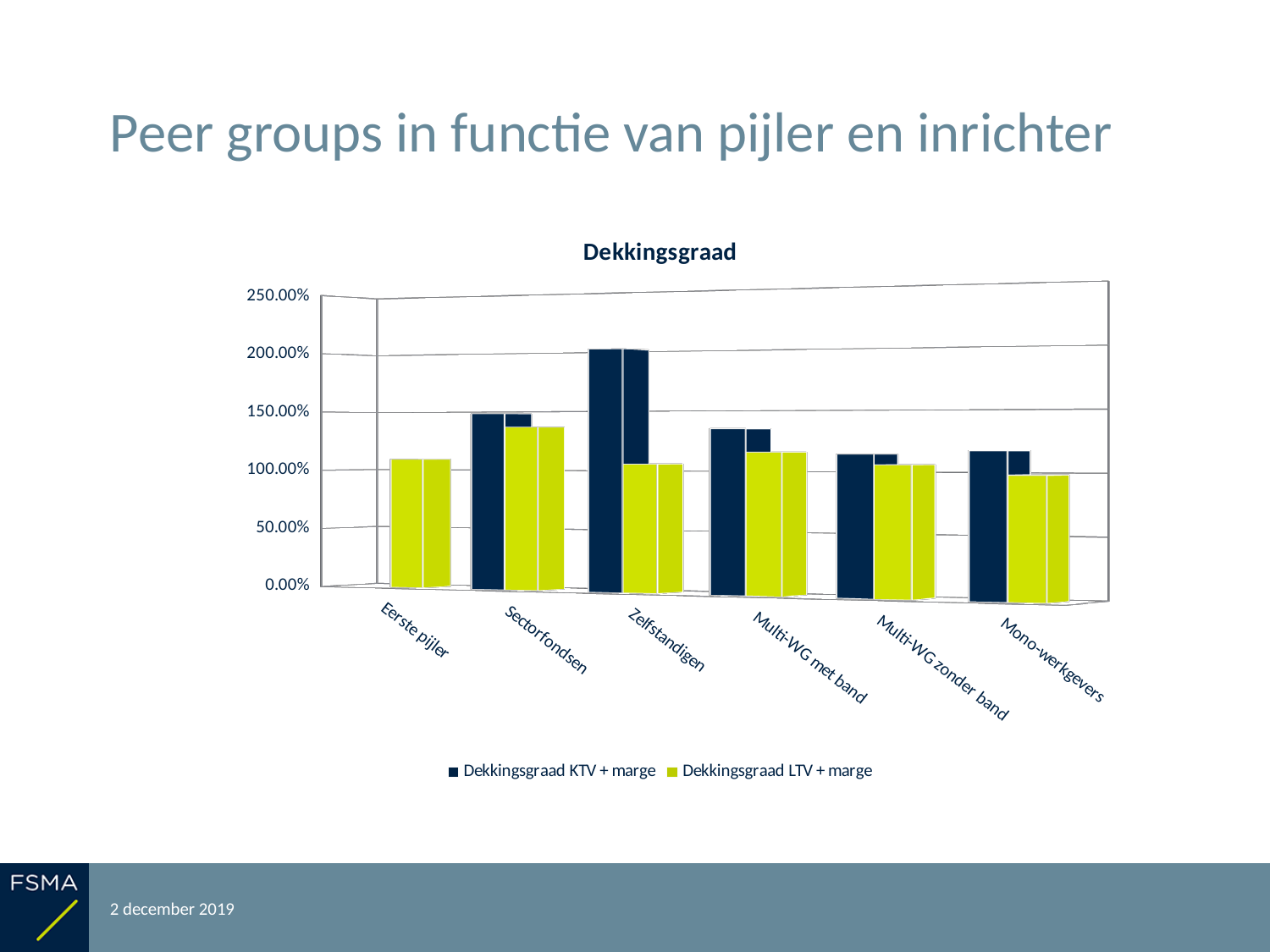
How many series does the legend list? 2 Is the value for Dekkingsgraad LTV + marge for Eerste pijler greater or less than 50.00%? greater What is the title of the chart? Dekkingsgraad Is the value for Dekkingsgraad KTV + marge for Zelfstandigen greater or less than 150.00%? greater Is the value for Dekkingsgraad LTV + marge for Sectorfondsen greater or less than 100.00%? greater For Zelfstandigen, which is larger: Dekkingsgraad KTV + marge or Dekkingsgraad LTV + marge? Dekkingsgraad KTV + marge How many categories are shown on the x axis? 6 What kind of chart is shown on the slide? Bar chart Which category has the highest value for Dekkingsgraad KTV + marge? Zelfstandigen What are the two series named in the legend? Dekkingsgraad KTV + marge and Dekkingsgraad LTV + marge